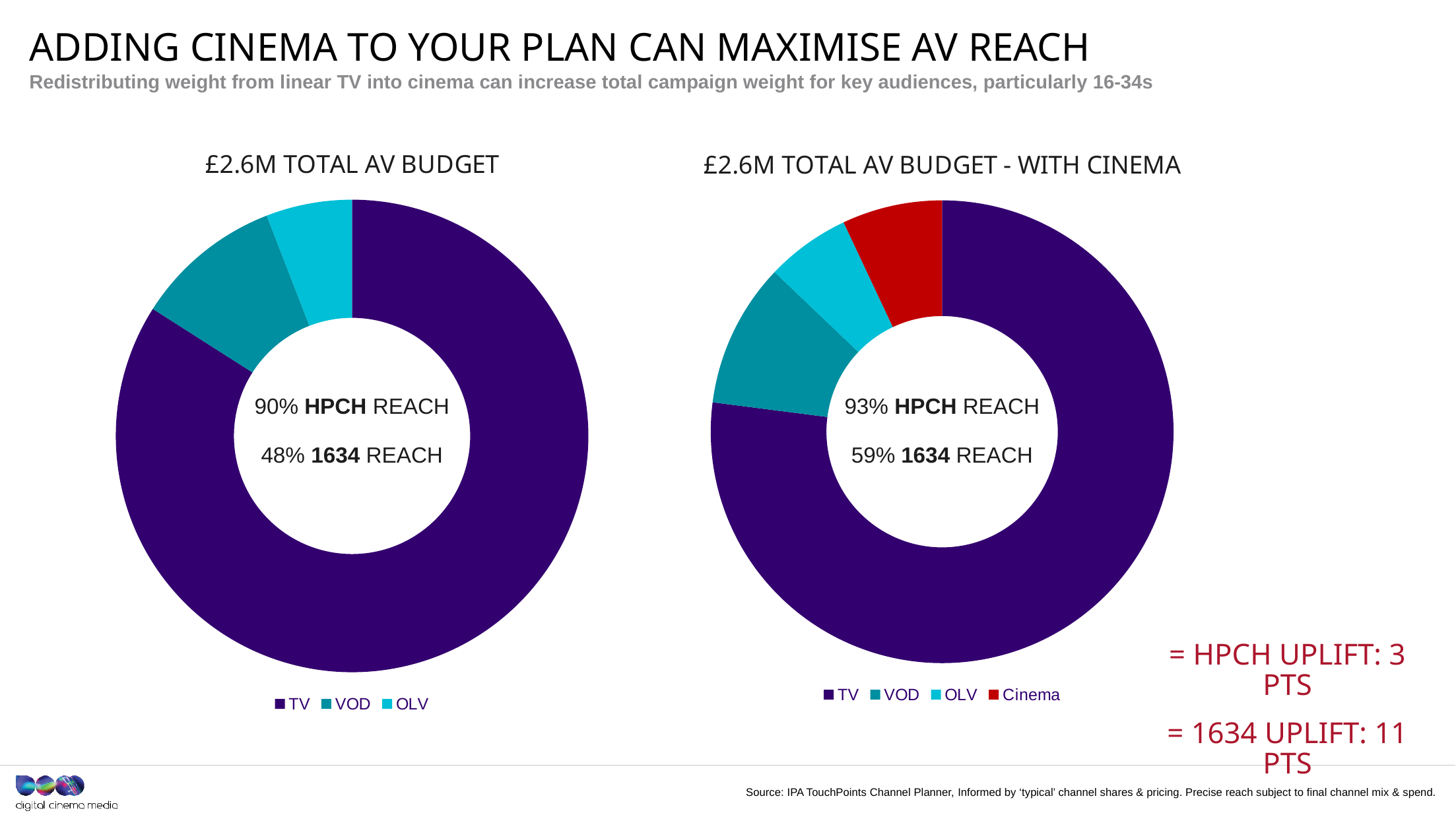
Which category appears in the legend of the right chart but not in the legend of the left chart? Cinema What is the difference in 1634 reach between the right chart (with cinema) and the left chart? 11 pts In the left chart, "£2.6M TOTAL AV BUDGET", which category has the smallest share? OLV In the left chart, "£2.6M TOTAL AV BUDGET", which category has the largest share? TV What colour is the Cinema slice in the right chart, "£2.6M TOTAL AV BUDGET - WITH CINEMA"? Red How many categories does the legend of the left chart, "£2.6M TOTAL AV BUDGET", list? 3 What 1634 reach is shown in the centre of the right chart, "£2.6M TOTAL AV BUDGET - WITH CINEMA"? 59% What kind of chart is the "£2.6M TOTAL AV BUDGET" chart on the left? Doughnut (pie) chart What HPCH reach is shown in the centre of the left chart, "£2.6M TOTAL AV BUDGET"? 90% How many categories does the legend of the right chart, "£2.6M TOTAL AV BUDGET - WITH CINEMA", list? 4 In the right chart, "£2.6M TOTAL AV BUDGET - WITH CINEMA", which category has the largest share? TV In the right chart, "£2.6M TOTAL AV BUDGET - WITH CINEMA", which is larger, the VOD slice or the TV slice? TV